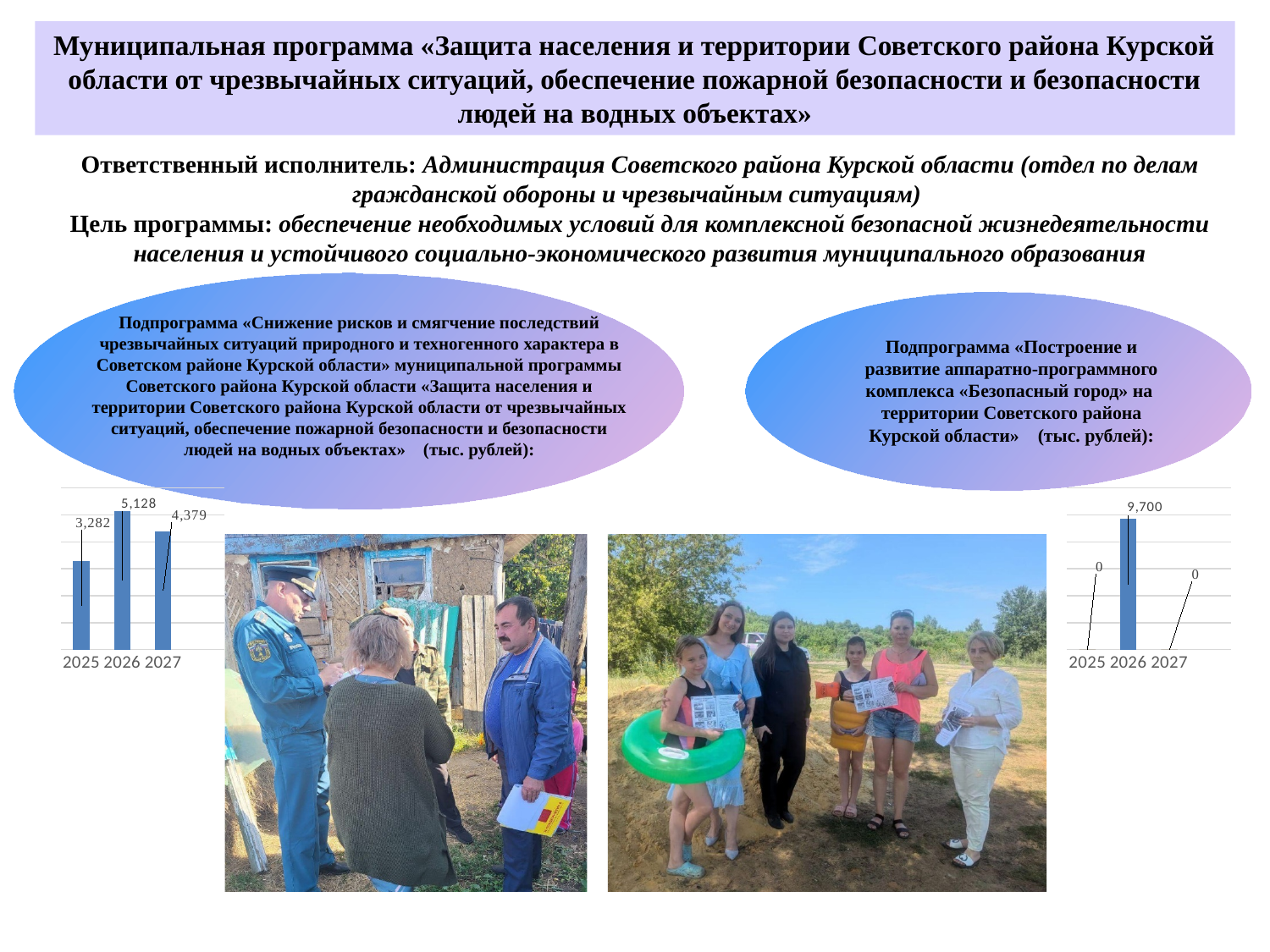
In the left chart (bottom-left of the slide), which is larger, the value for 2027 or the value for 2025? 2027 In the left chart (bottom-left of the slide), what is the difference between the values for 2026 and 2025? 1,846 In the right chart (bottom-right of the slide), what is the value for 2025? 0 In the right chart (bottom-right of the slide), what is the value for 2026? 9,700 In the left chart (bottom-left of the slide), which year has the highest value? 2026 In the left chart (bottom-left of the slide), which year has the lowest value? 2025 In the left chart (bottom-left of the slide), what is the value for 2027? 4,379 In the left chart (bottom-left of the slide), what is the value for 2025? 3,282 In the left chart (bottom-left of the slide), what is the value for 2026? 5,128 What kind of chart is the right chart (bottom-right of the slide)? Bar chart How many years are shown on the x axis of the left chart (bottom-left of the slide)? 3 In the right chart (bottom-right of the slide), which year has the highest value? 2026